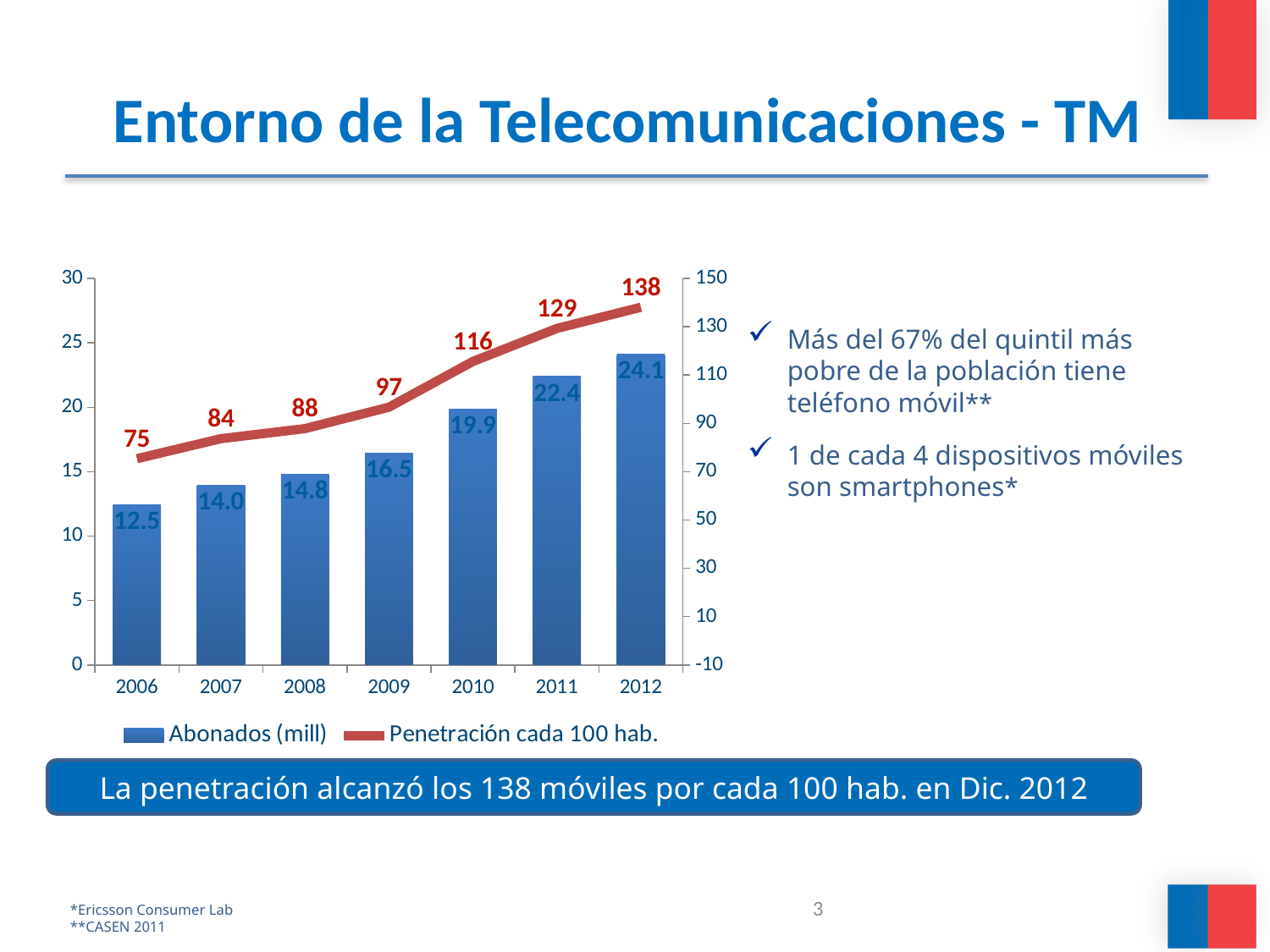
Does the Penetración cada 100 hab. series rise or fall from 2006 to 2012? rise What is the difference in Penetración cada 100 hab. between 2008 and 2007? 4 What is the value of Abonados (mill) for 2006? 12.5 What is the value of Abonados (mill) for 2009? 16.5 Which year has the lowest value for Abonados (mill)? 2006 What is the value of Penetración cada 100 hab. for 2010? 116 How many years are shown on the x axis? 7 Which year has the highest value for Penetración cada 100 hab.? 2012 How many series does the legend list? 2 What colour is the Penetración cada 100 hab. line? red What is the difference in Abonados (mill) between 2012 and 2011? 1.7 Which is larger, Abonados (mill) in 2010 or in 2008? 2010